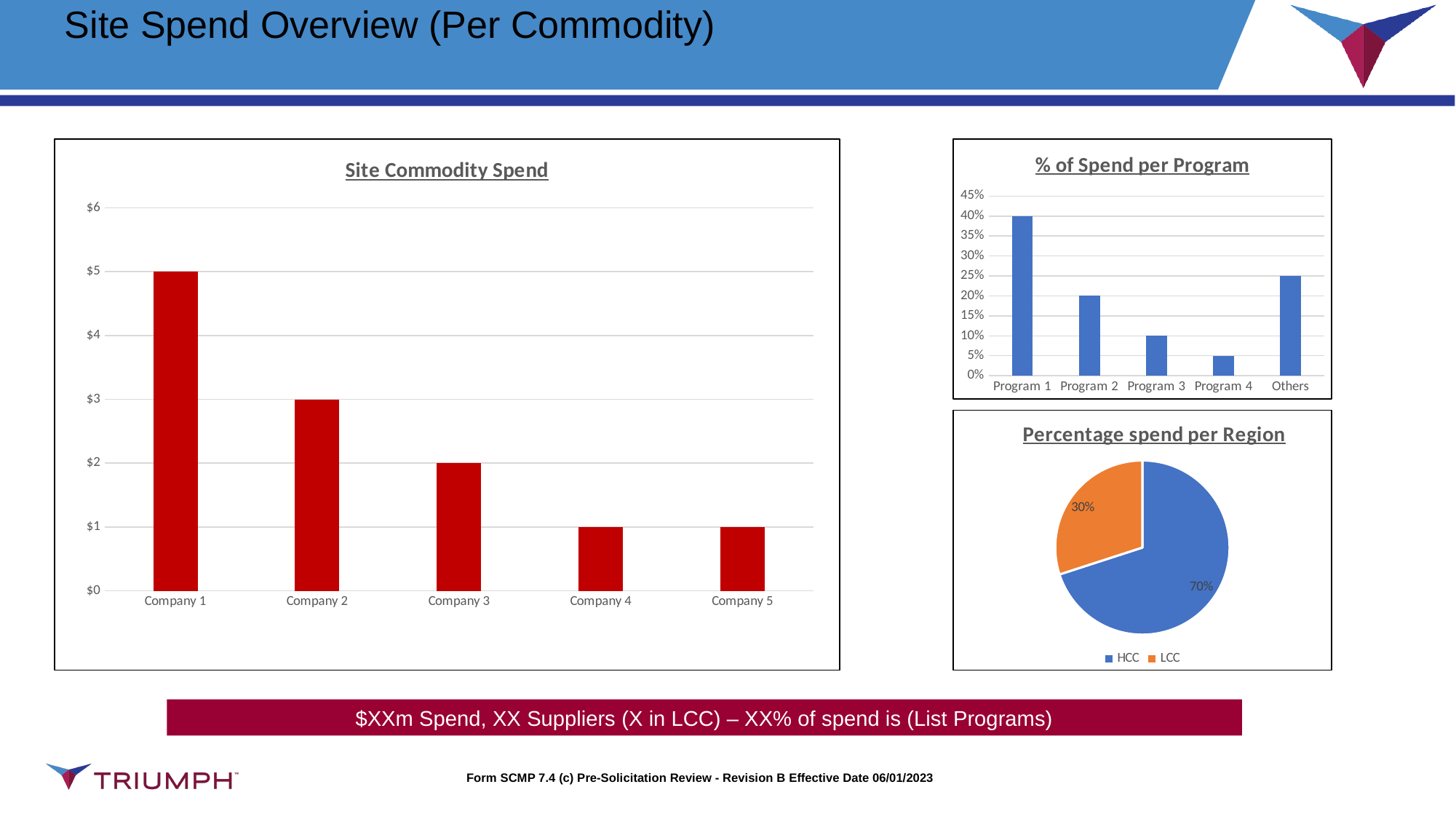
In the % of Spend per Program chart, which category has the lowest value? Program 4 In the Site Commodity Spend chart, what is the value for Company 1? $5 In the % of Spend per Program chart, which is larger, Program 3 or Others? Others How many series does the legend of the Percentage spend per Region chart list? 2 What kind of chart is the Site Commodity Spend chart? bar chart In the % of Spend per Program chart, is the value for Program 1 greater or less than 35%? greater In the Site Commodity Spend chart, do the values rise or fall from Company 1 to Company 4? fall In the Percentage spend per Region chart, what share does HCC have? 70% In the % of Spend per Program chart, what is the value for Program 2? 20% In the Site Commodity Spend chart, which company has the highest spend? Company 1 In the Site Commodity Spend chart, how many companies are shown? 5 In the Site Commodity Spend chart, what is the difference between Company 1 and Company 2? $2